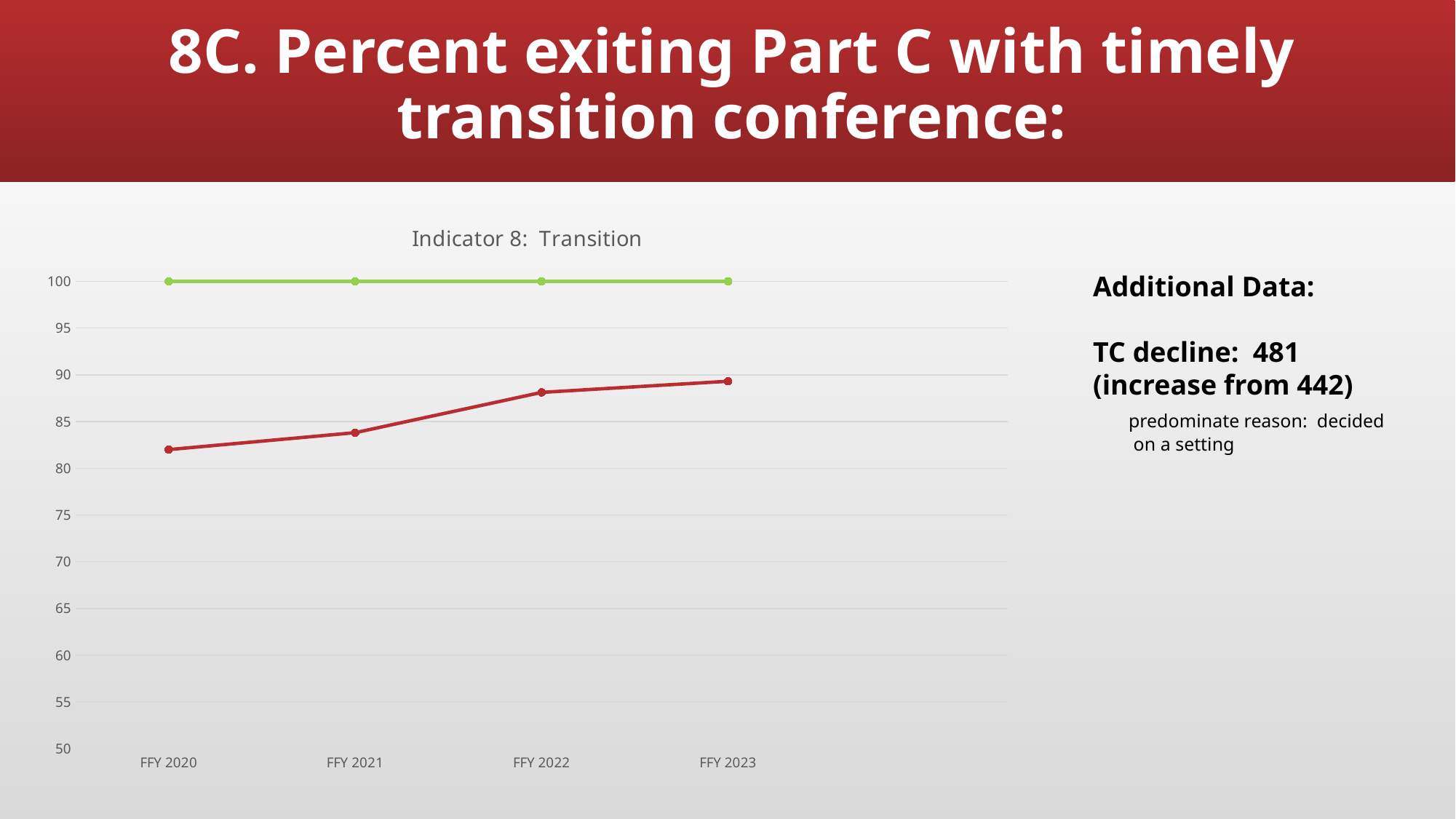
How many FFY categories are shown on the x axis? 4 Is the red line's value for FFY 2020 greater or less than 85? less In FFY 2023, which line is higher, the green line or the red line? Green line What kind of chart is shown on the slide? Line chart Does the red line rise or fall from FFY 2020 to FFY 2023? Rise Which year has the lowest value on the red line? FFY 2020 What is the title of the chart? Indicator 8: Transition What value does the green line hold across all years? 100 Is the red line's value for FFY 2022 greater or less than 85? greater Is the red line's value for FFY 2021 greater or less than 80? greater How many lines are plotted on the chart? 2